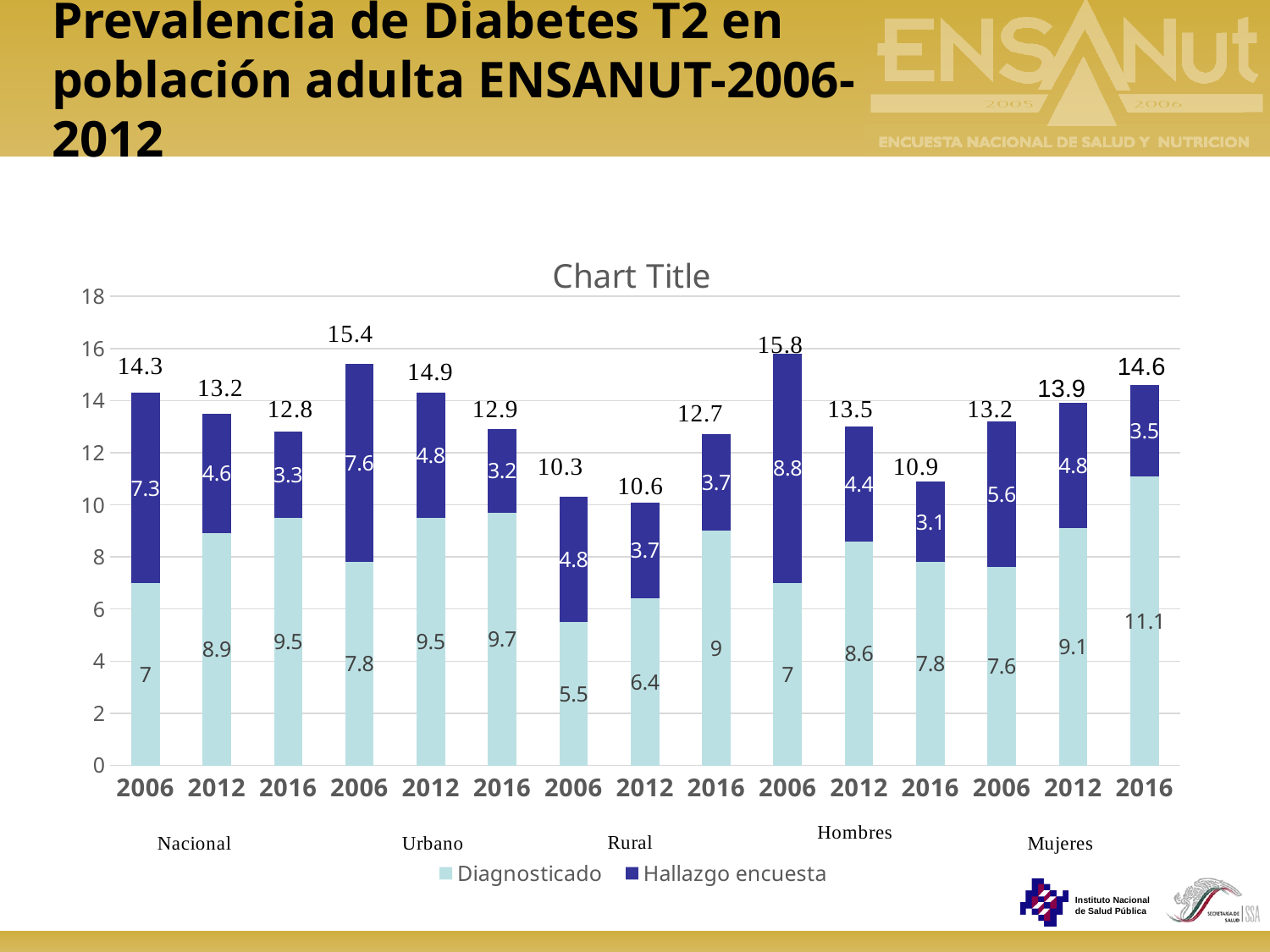
What is the Diagnosticado value for Nacional in 2006? 7 What are the two series named in the legend? Diagnosticado and Hallazgo encuesta What is the difference between the Diagnosticado value for Mujeres 2016 and for Rural 2006? 5.6 Does the Diagnosticado value for Mujeres rise or fall from 2006 to 2016? Rises What kind of chart is shown on the slide? Stacked bar chart Which is larger, the Hallazgo encuesta value for Nacional 2006 or for Urbano 2006? Urbano 2006 What total value is printed above the Hombres 2006 bar? 15.8 How many stacked bars are plotted in the chart? 15 What is the Hallazgo encuesta value for Hombres in 2006? 8.8 How many series does the legend list? 2 Which bar has the lowest Diagnosticado value? Rural 2006 (5.5) Which bar has the highest Diagnosticado value? Mujeres 2016 (11.1)